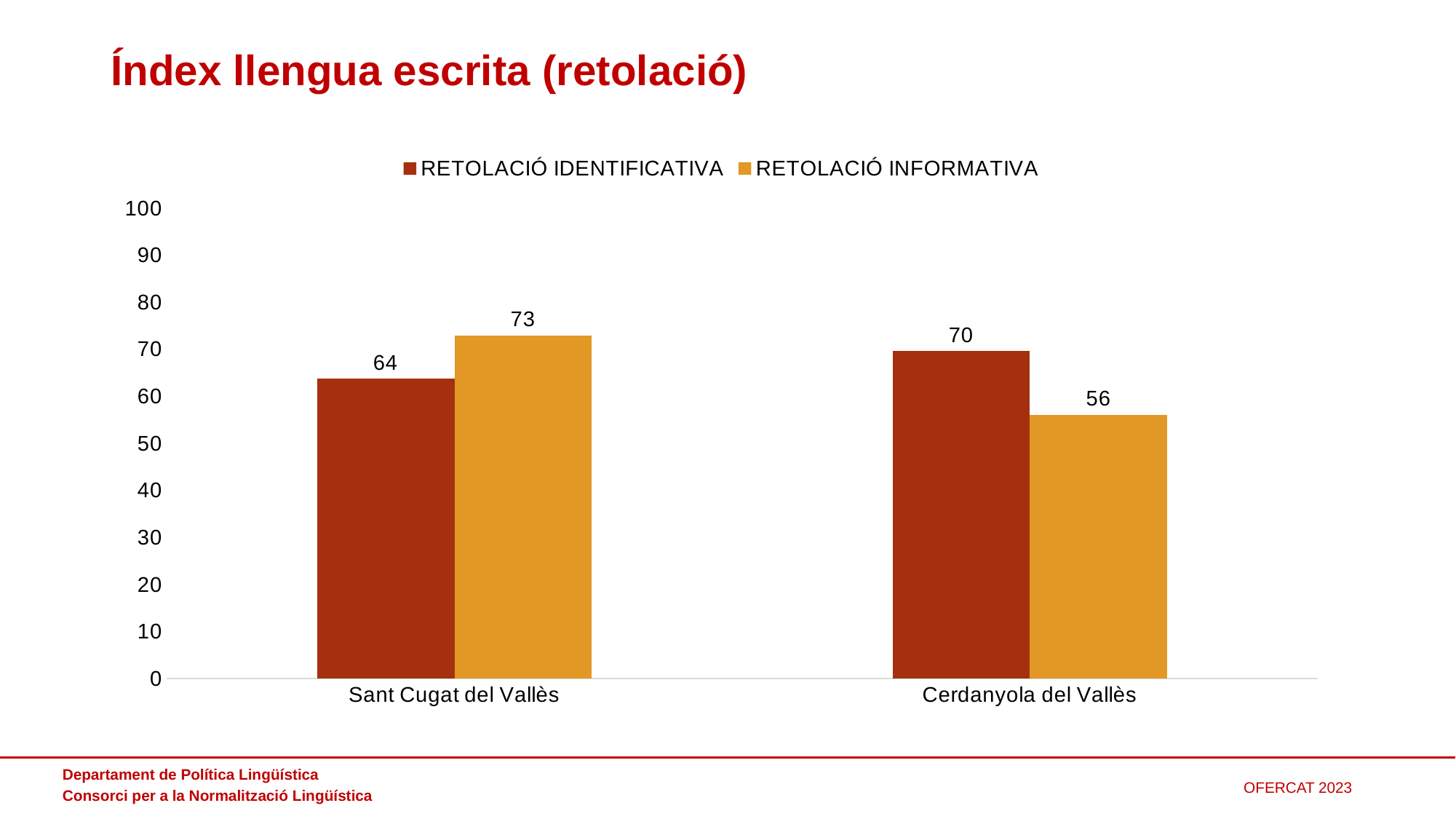
What is the value of RETOLACIÓ IDENTIFICATIVA for Sant Cugat del Vallès? 64 What is the value of RETOLACIÓ INFORMATIVA for Sant Cugat del Vallès? 73 What is the difference between RETOLACIÓ INFORMATIVA and RETOLACIÓ IDENTIFICATIVA for Sant Cugat del Vallès? 9 What is the value of RETOLACIÓ IDENTIFICATIVA for Cerdanyola del Vallès? 70 Which municipality has the lowest value for RETOLACIÓ IDENTIFICATIVA? Sant Cugat del Vallès How many series does the legend list? 2 How many municipalities are shown on the x axis of the chart? 2 What kind of chart is shown on the slide? Bar chart For Cerdanyola del Vallès, which is larger: RETOLACIÓ IDENTIFICATIVA or RETOLACIÓ INFORMATIVA? RETOLACIÓ IDENTIFICATIVA Which municipality has the highest value for RETOLACIÓ INFORMATIVA? Sant Cugat del Vallès What is the difference between RETOLACIÓ IDENTIFICATIVA and RETOLACIÓ INFORMATIVA for Cerdanyola del Vallès? 14 What is the value of RETOLACIÓ INFORMATIVA for Cerdanyola del Vallès? 56